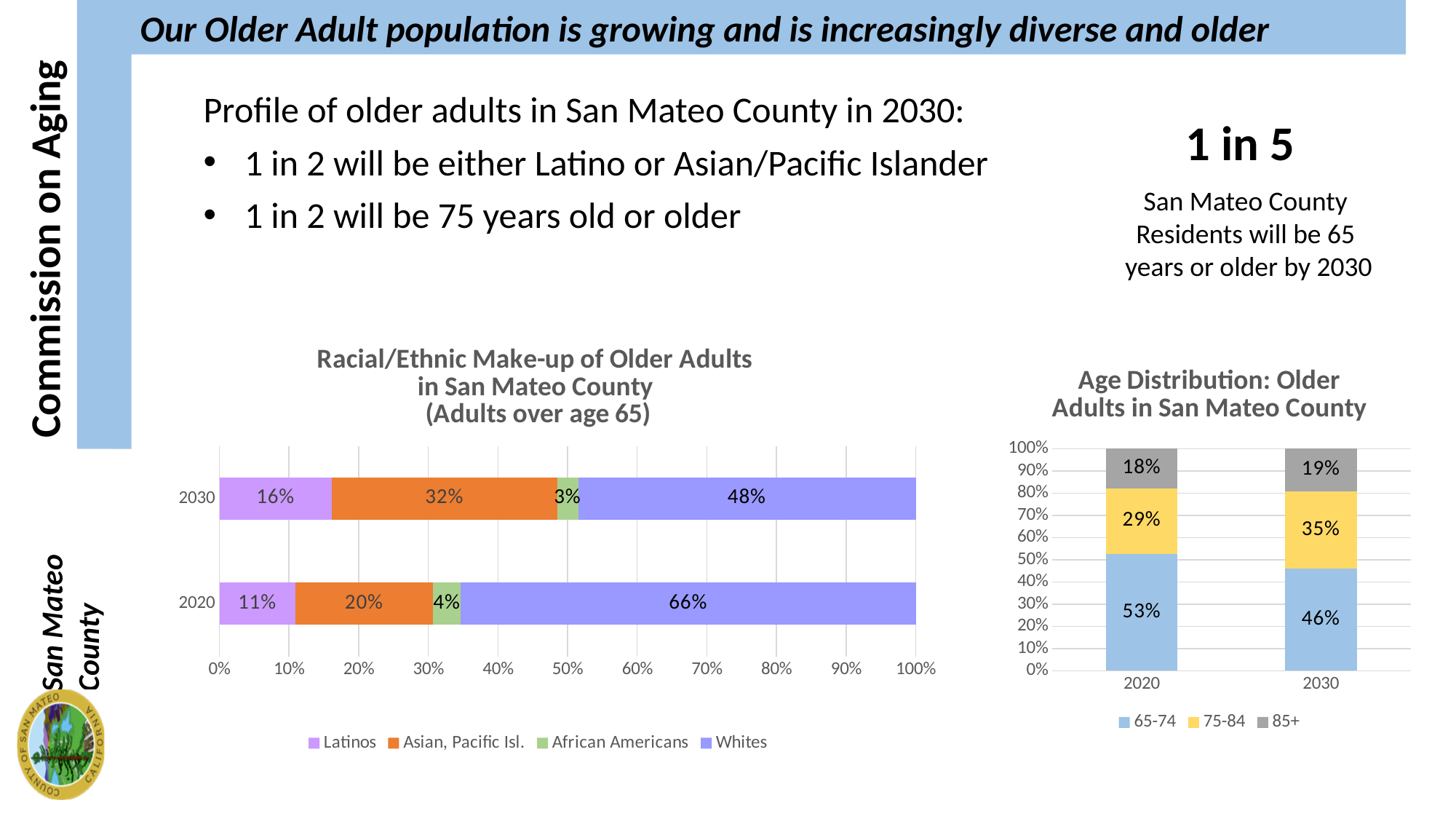
In the 'Age Distribution: Older Adults in San Mateo County' chart, what is the difference between the 65-74 share in 2020 and in 2030? 7% In the 'Age Distribution: Older Adults in San Mateo County' chart, which age group has the largest share in 2030? 65-74 In the 'Age Distribution: Older Adults in San Mateo County' chart, what is the value for 75-84 in 2030? 35% In the 'Racial/Ethnic Make-up of Older Adults in San Mateo County' chart, what is the value for Whites in 2020? 66% In the 'Racial/Ethnic Make-up of Older Adults in San Mateo County' chart, is the Latinos share larger in 2020 or in 2030? 2030 In the 'Racial/Ethnic Make-up of Older Adults in San Mateo County' chart, which group has the smallest share in 2030? African Americans How many series does the legend of the 'Racial/Ethnic Make-up of Older Adults in San Mateo County' chart list? 4 In the 'Racial/Ethnic Make-up of Older Adults in San Mateo County' chart, what is the difference between the Whites share in 2020 and in 2030? 18% How many series does the legend of the 'Age Distribution: Older Adults in San Mateo County' chart list? 3 In the 'Racial/Ethnic Make-up of Older Adults in San Mateo County' chart, what is the value for Asian, Pacific Isl. in 2030? 32% In the 'Age Distribution: Older Adults in San Mateo County' chart, what is the value for 65-74 in 2020? 53% What kind of chart is the 'Racial/Ethnic Make-up of Older Adults in San Mateo County' chart? Stacked bar chart